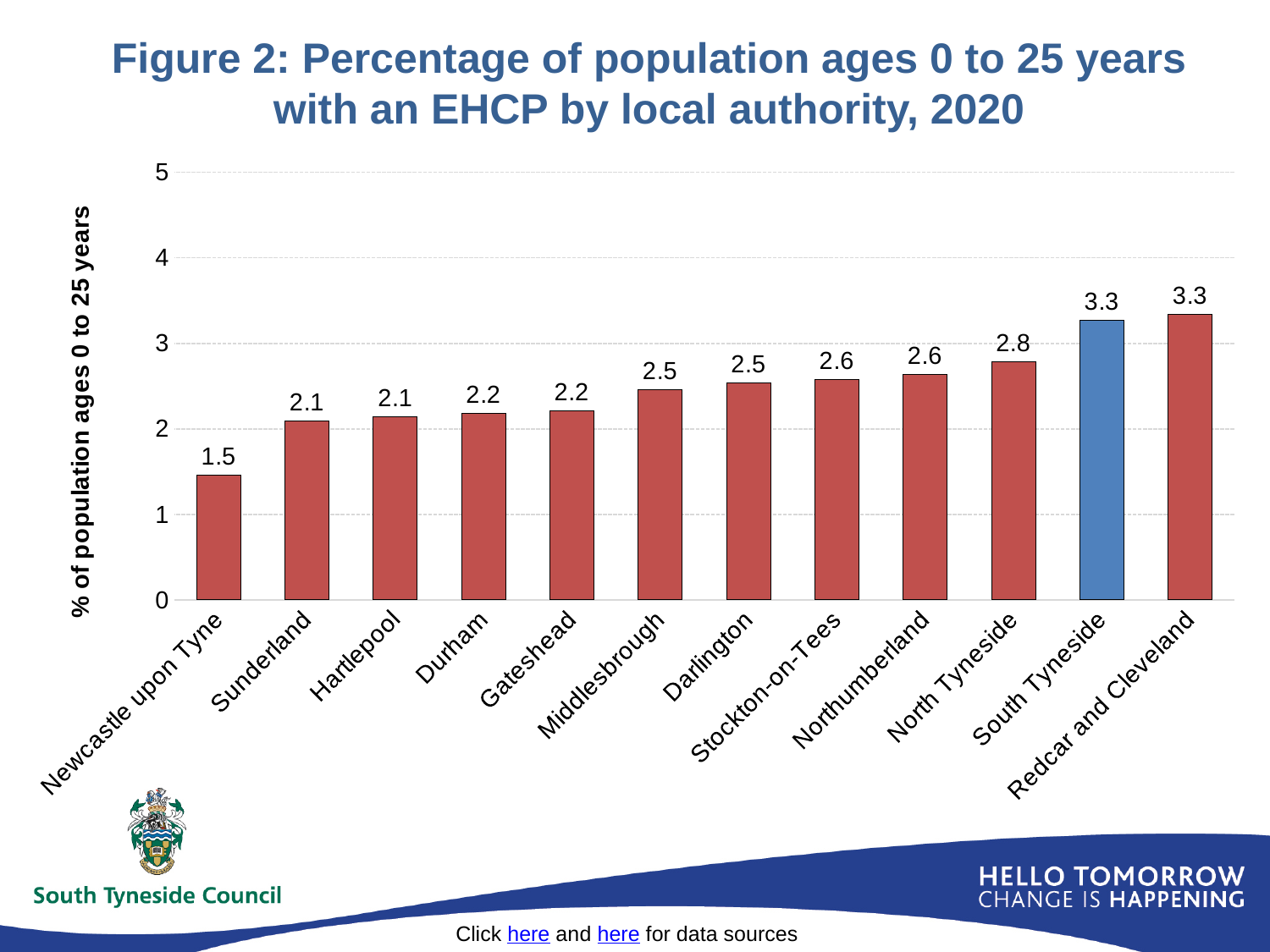
What is the value for North Tyneside? 2.8 What kind of chart is shown on the slide? bar chart What is the difference between the values for North Tyneside and Sunderland? 0.7 What is the value for Middlesbrough? 2.5 What is the difference between the values for South Tyneside and Newcastle upon Tyne? 1.8 Is the value for Stockton-on-Tees greater or less than 3? less How many local authorities are shown on the chart? 12 What is the value for Newcastle upon Tyne? 1.5 What is the value for South Tyneside? 3.3 Which is larger, the value for Northumberland or the value for Durham? Northumberland Which bar is coloured differently (blue) from the others? South Tyneside Which local authority has the lowest value? Newcastle upon Tyne